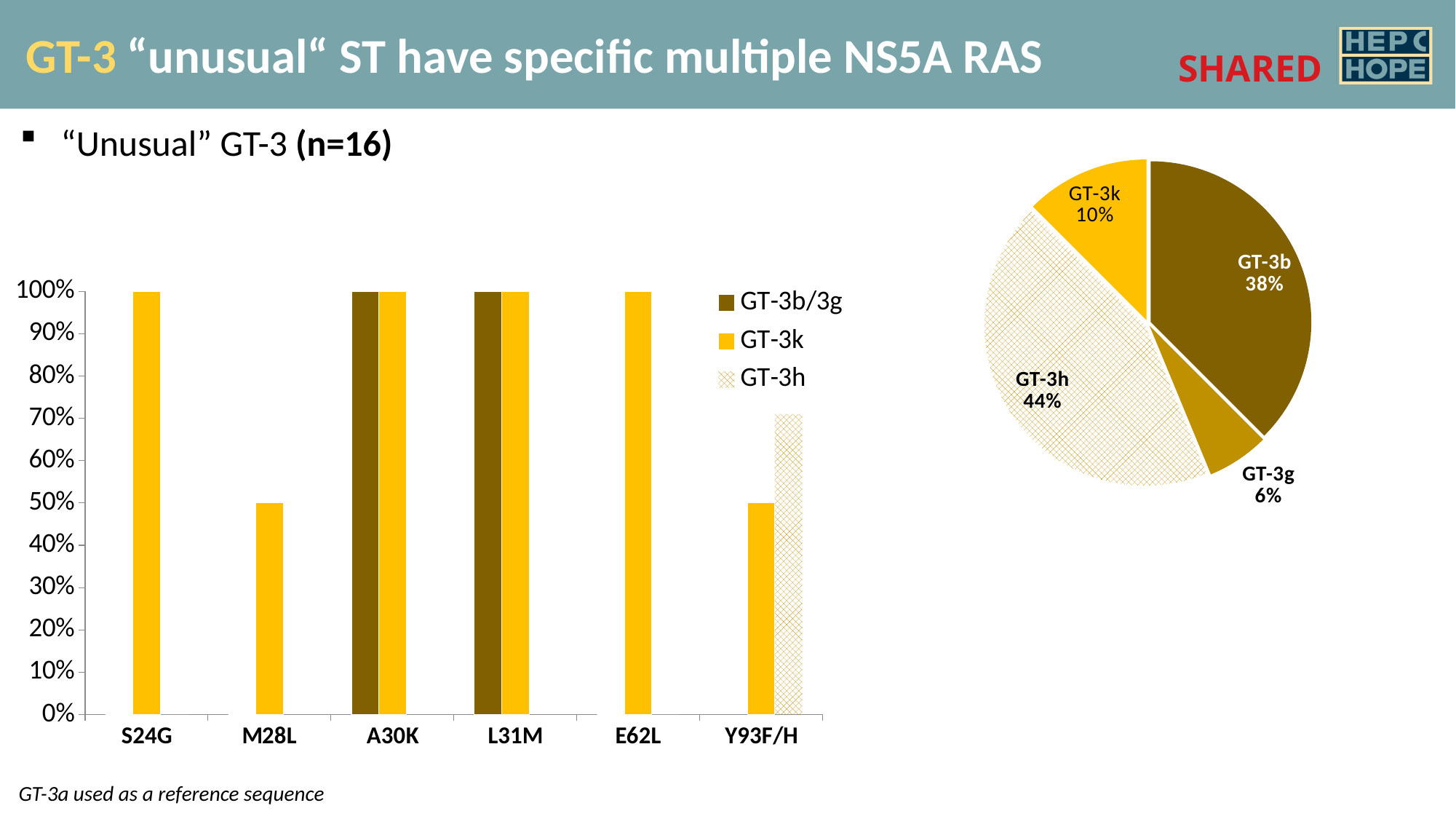
In the bar chart on the left, how many series does the legend list? 3 In the bar chart on the left, what is the value for GT-3k at M28L? 50% In the pie chart on the right, what is the difference between the GT-3b and GT-3k shares? 28% In the bar chart on the left, what is the value for GT-3k at S24G? 100% In the bar chart on the left, which is larger at Y93F/H: GT-3k or GT-3h? GT-3h In the pie chart on the right, which slice is the smallest? GT-3g What kind of chart is the chart on the left? bar chart In the bar chart on the left, what is the value for GT-3b/3g at L31M? 100% In the pie chart on the right, how many slices are there? 4 In the bar chart on the left, how many categories are shown on the x axis? 6 In the pie chart on the right, what share does GT-3h have? 44% In the bar chart on the left, is the value for GT-3h at Y93F/H greater or less than 60%? greater